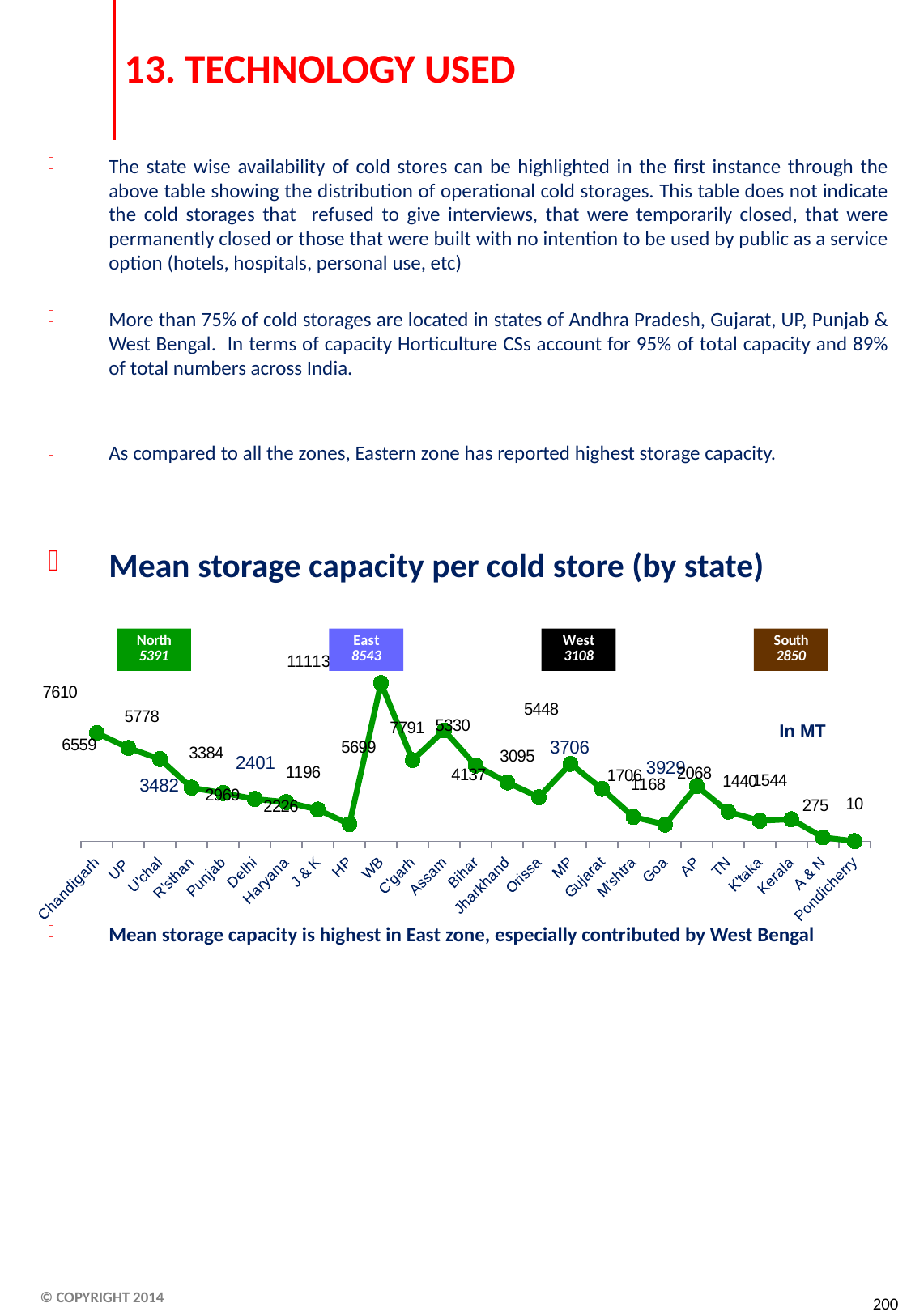
Which zone box shows the highest mean storage capacity? East What is the mean storage capacity per cold store for WB? 11113 What is the title of the chart? Mean storage capacity per cold store (by state) What is the difference between the East zone value (8543) and the North zone value (5391)? 3152 What is the mean storage capacity per cold store for Pondicherry? 10 What mean storage capacity is shown in the South zone box? 2850 What mean storage capacity is shown in the East zone box? 8543 Which state has the highest mean storage capacity per cold store? WB Which is larger, the mean storage capacity for WB or for HP? WB How many states/categories are plotted along the x axis of the chart? 25 Which state has the lowest mean storage capacity per cold store? Pondicherry What kind of chart is shown on the slide? line chart